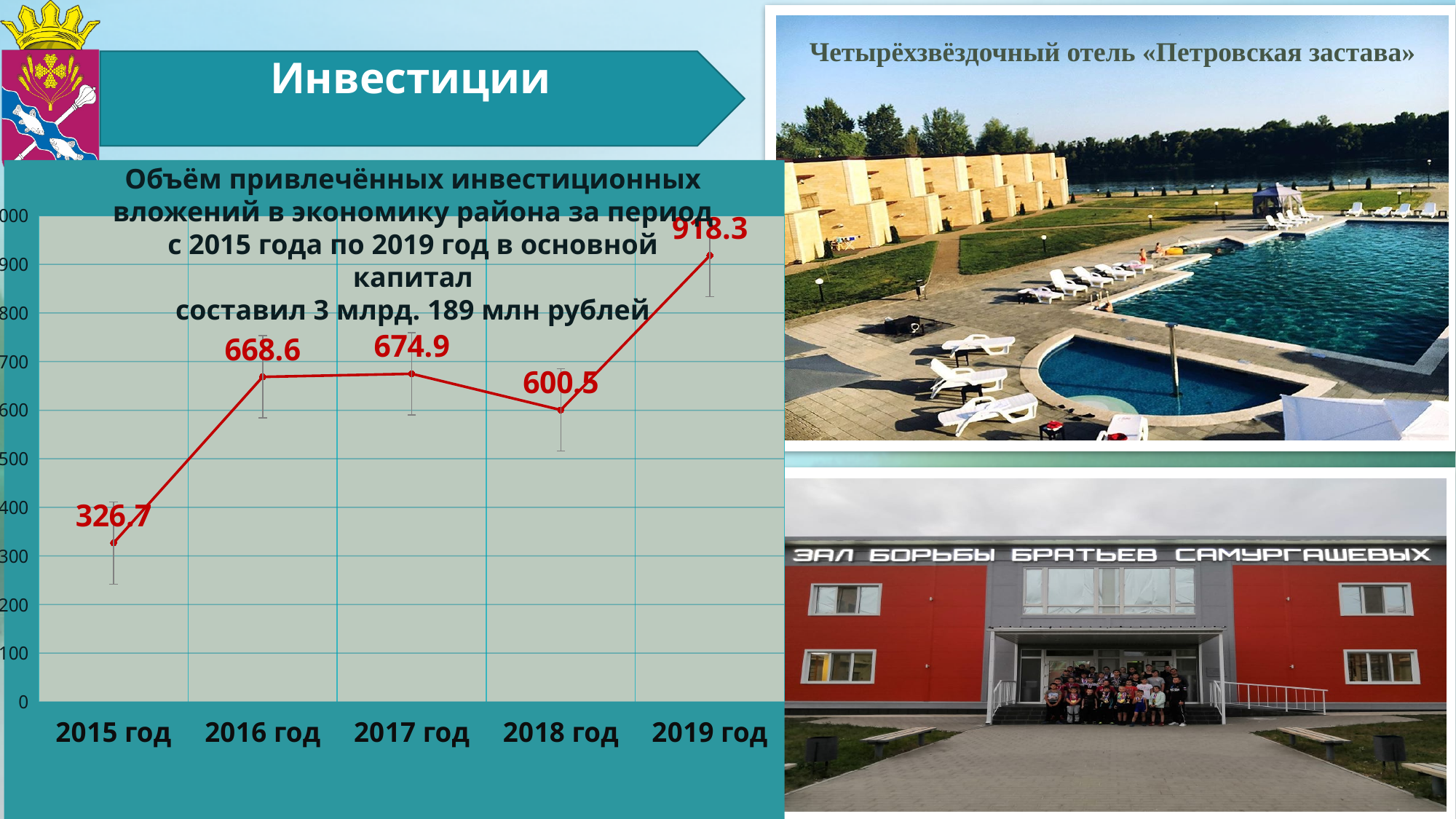
Which year has the lowest value? 2015 год What is the difference between the values for 2016 год and 2018 год? 68.1 What is the difference between the values for 2019 год and 2015 год? 591.6 What is the value for 2015 год? 326.7 What is the value for 2019 год? 918.3 Is the value for 2015 год greater or less than 400? less Which is larger, the value for 2016 год or the value for 2018 год? 2016 год What is the value for 2017 год? 674.9 Does the value rise or fall from 2017 год to 2018 год? fall Which year has the highest value? 2019 год What kind of chart is shown on the slide? line chart How many years are plotted on the chart? 5